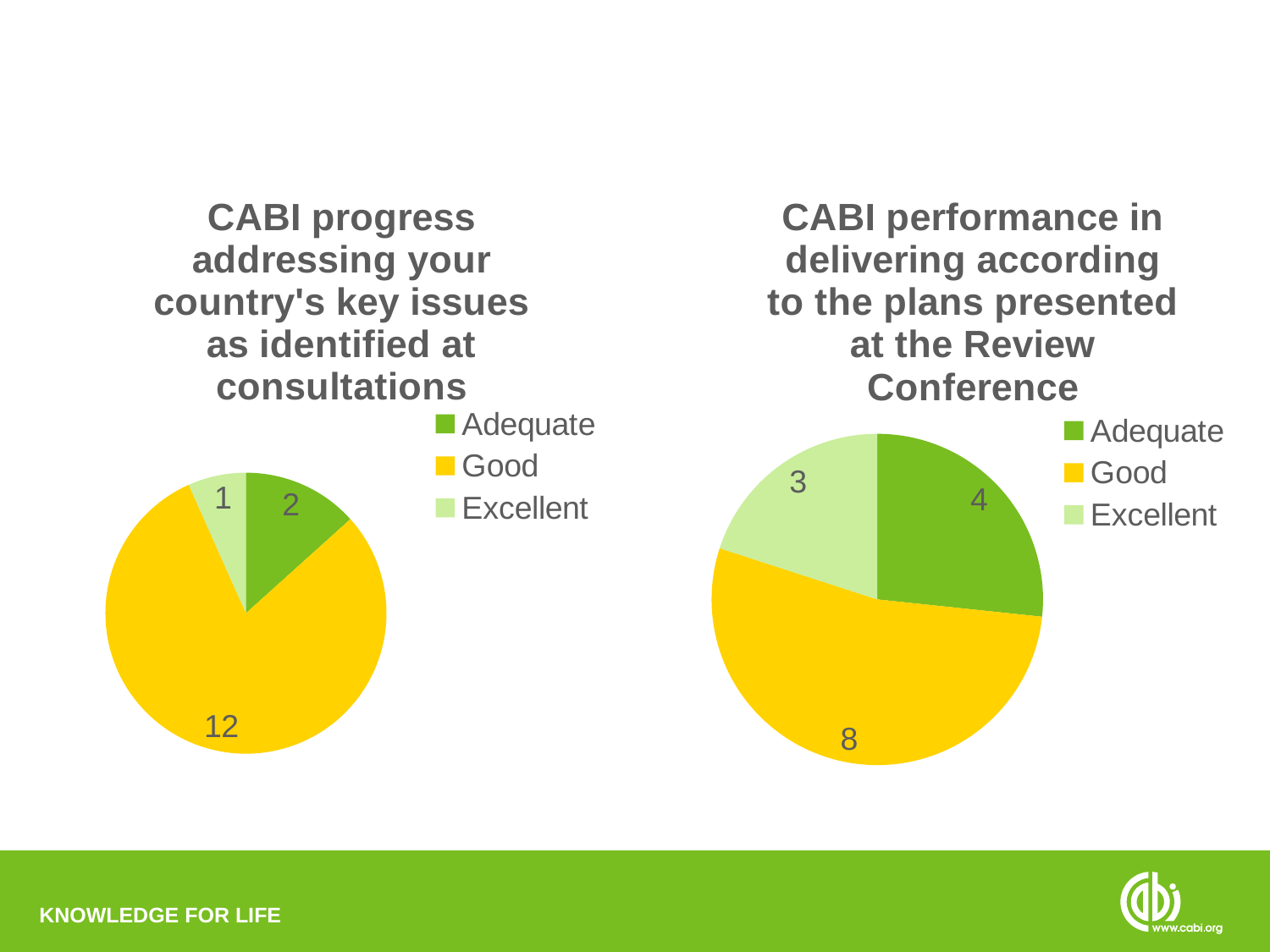
In the right chart, 'CABI performance in delivering according to the plans presented at the Review Conference', what is the difference between Good and Adequate? 4 In the left chart, 'CABI progress addressing your country's key issues as identified at consultations', what is the value for Good? 12 In the right chart, 'CABI performance in delivering according to the plans presented at the Review Conference', what is the value for Excellent? 3 In the left chart, 'CABI progress addressing your country's key issues as identified at consultations', which category has the largest slice? Good In the left chart, 'CABI progress addressing your country's key issues as identified at consultations', which is larger, Adequate or Excellent? Adequate In the right chart, 'CABI performance in delivering according to the plans presented at the Review Conference', what share of the total does Excellent represent? 20% How many slices does the right chart, 'CABI performance in delivering according to the plans presented at the Review Conference', have? 3 In the right chart, 'CABI performance in delivering according to the plans presented at the Review Conference', which category has the smallest slice? Excellent In the right chart, 'CABI performance in delivering according to the plans presented at the Review Conference', what is the value for Adequate? 4 In the left chart, 'CABI progress addressing your country's key issues as identified at consultations', which category has the smallest slice? Excellent In the left chart, 'CABI progress addressing your country's key issues as identified at consultations', what share of the total does Good represent? 80% What type of chart is the left chart, 'CABI progress addressing your country's key issues as identified at consultations'? Pie chart